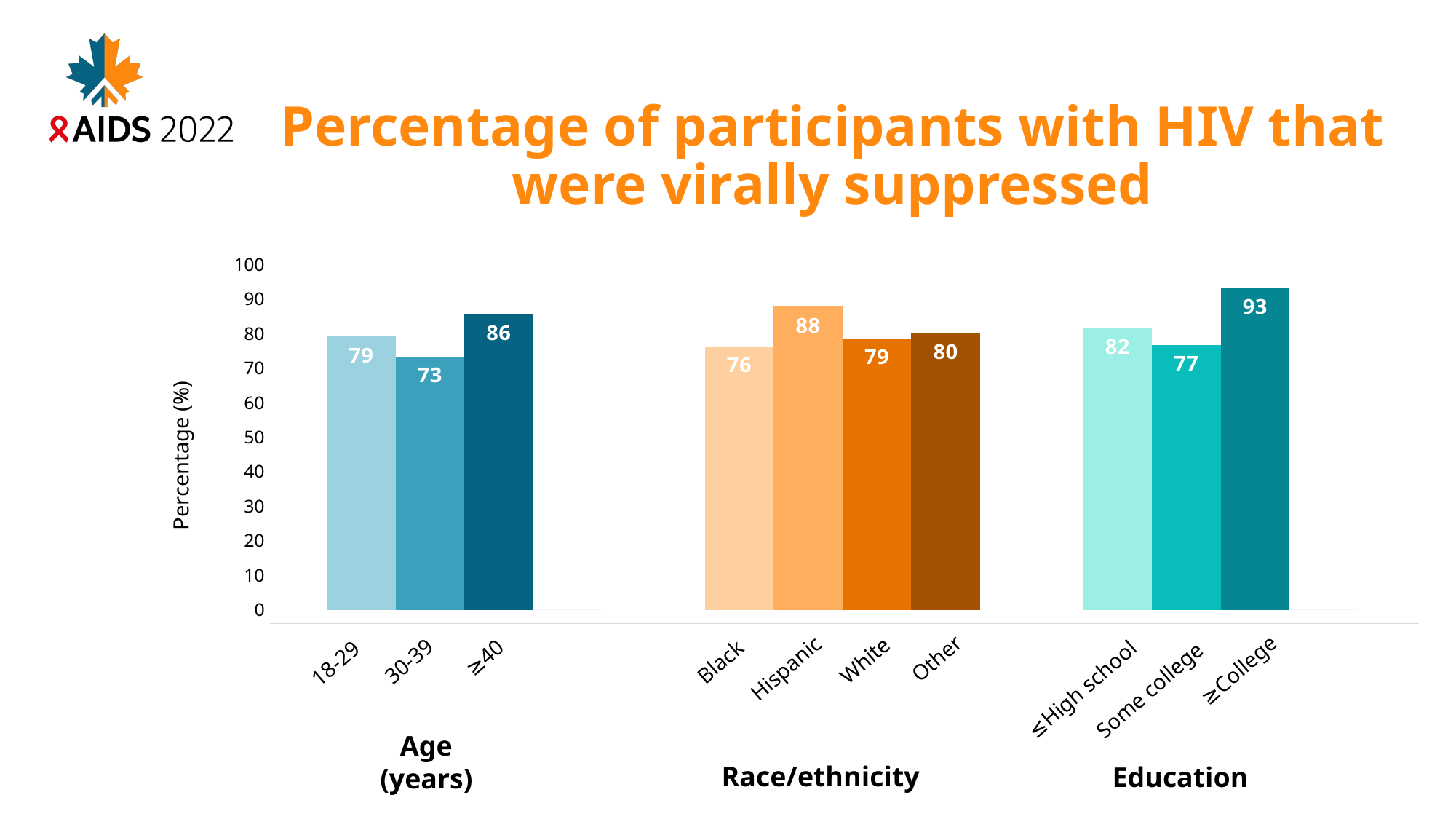
What is the label of the vertical axis? Percentage (%) Which is larger, the value for White participants or the value for Black participants? White What is the value shown for Hispanic participants? 88 Which age group has the lowest percentage virally suppressed? 30-39 What is the difference between the ≥College value and the Some college value? 16 What type of chart is shown on the slide? Bar chart Which race/ethnicity group has the lowest percentage virally suppressed? Black What percentage of participants aged 30-39 were virally suppressed? 73 How many bars are plotted in total across all three groups? 10 What is the value shown for participants with some college education? 77 Which category across the whole chart has the highest percentage virally suppressed? ≥College What is the difference between the ≥40 and 18-29 age group values? 7